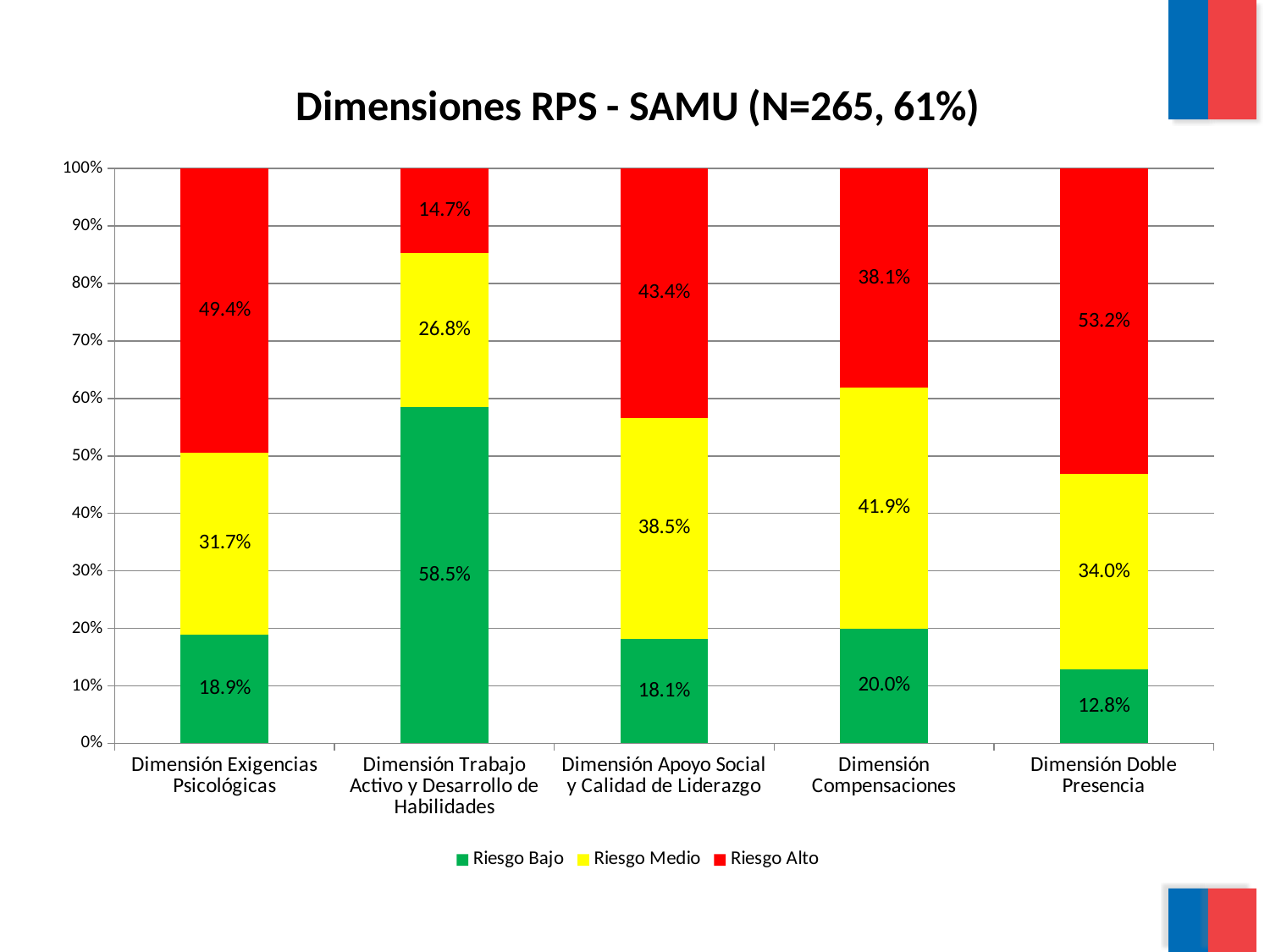
How many dimensions are shown on the x axis? 5 What is the Riesgo Alto value for Dimensión Doble Presencia? 53.2% How many series does the legend list? 3 What is the Riesgo Bajo value for Dimensión Trabajo Activo y Desarrollo de Habilidades? 58.5% What kind of chart is shown on the slide? Stacked bar chart Which dimension has the highest Riesgo Alto value? Dimensión Doble Presencia What is the Riesgo Medio value for Dimensión Compensaciones? 41.9% Which colour represents Riesgo Alto in the chart? Red Which dimension has the lowest Riesgo Bajo value? Dimensión Doble Presencia What is the title of the chart? Dimensiones RPS - SAMU (N=265, 61%) What is the difference between the Riesgo Alto values for Dimensión Exigencias Psicológicas and Dimensión Apoyo Social y Calidad de Liderazgo? 6.0% Which is larger: the Riesgo Medio value for Dimensión Exigencias Psicológicas or for Dimensión Doble Presencia? Dimensión Doble Presencia